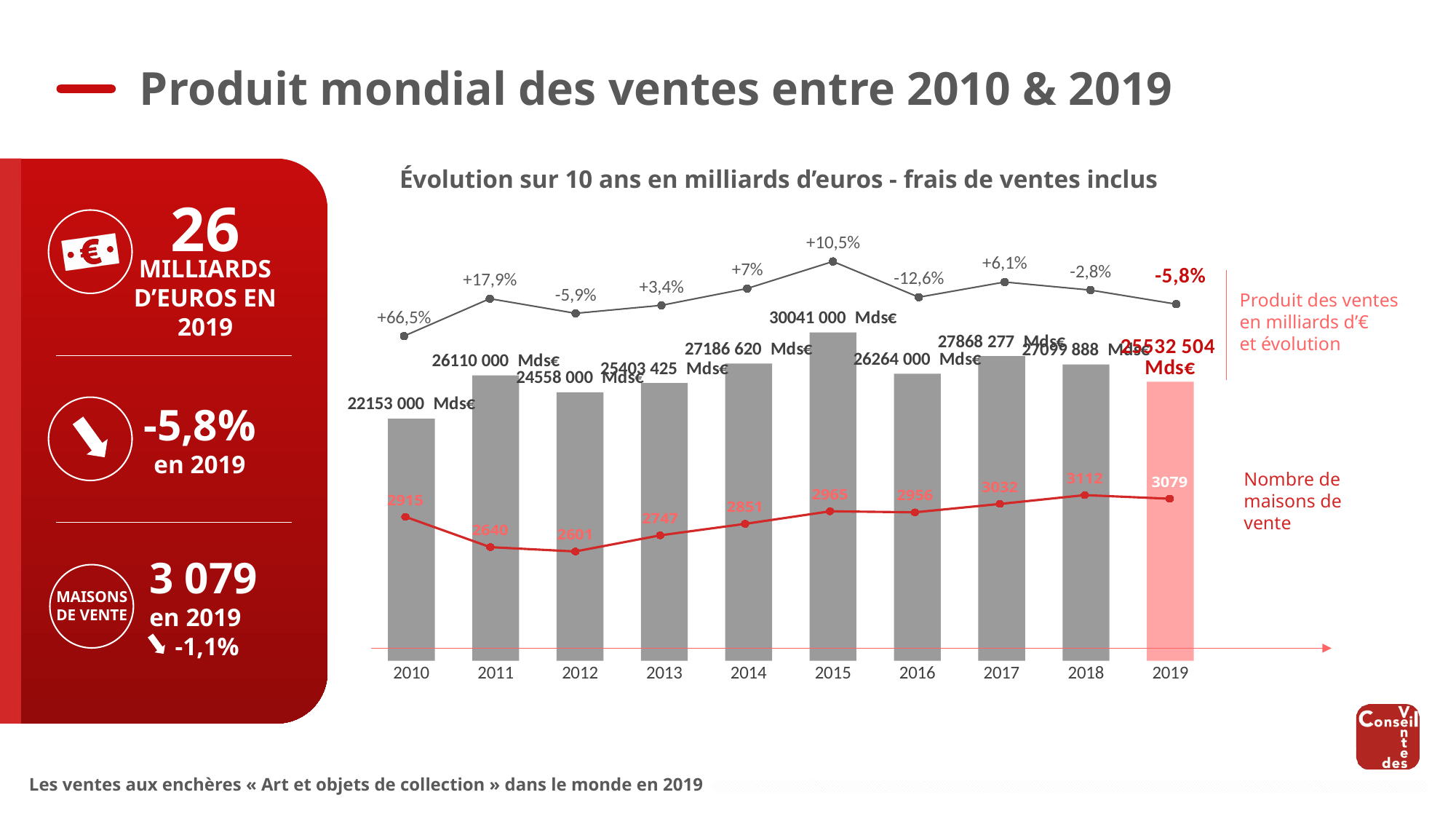
In which year is the Nombre de maisons de vente lowest? 2012 What percentage evolution is shown for 2016? -12,6% Which year's bar is highlighted in pink rather than grey? 2019 Which year has the lowest Produit des ventes bar? 2010 What is the value of the Produit des ventes bar for 2015? 30041 000 Mds€ What is the Nombre de maisons de vente for 2018? 3112 How many years are shown on the x axis of the chart? 10 Which year has the larger Produit des ventes bar, 2011 or 2012? 2011 What is the difference in Nombre de maisons de vente between 2018 and 2019? 33 What kind of chart is used to show the Produit des ventes values? Bar chart (with line series) In which year is the Nombre de maisons de vente highest? 2018 Which year has the highest Produit des ventes bar? 2015